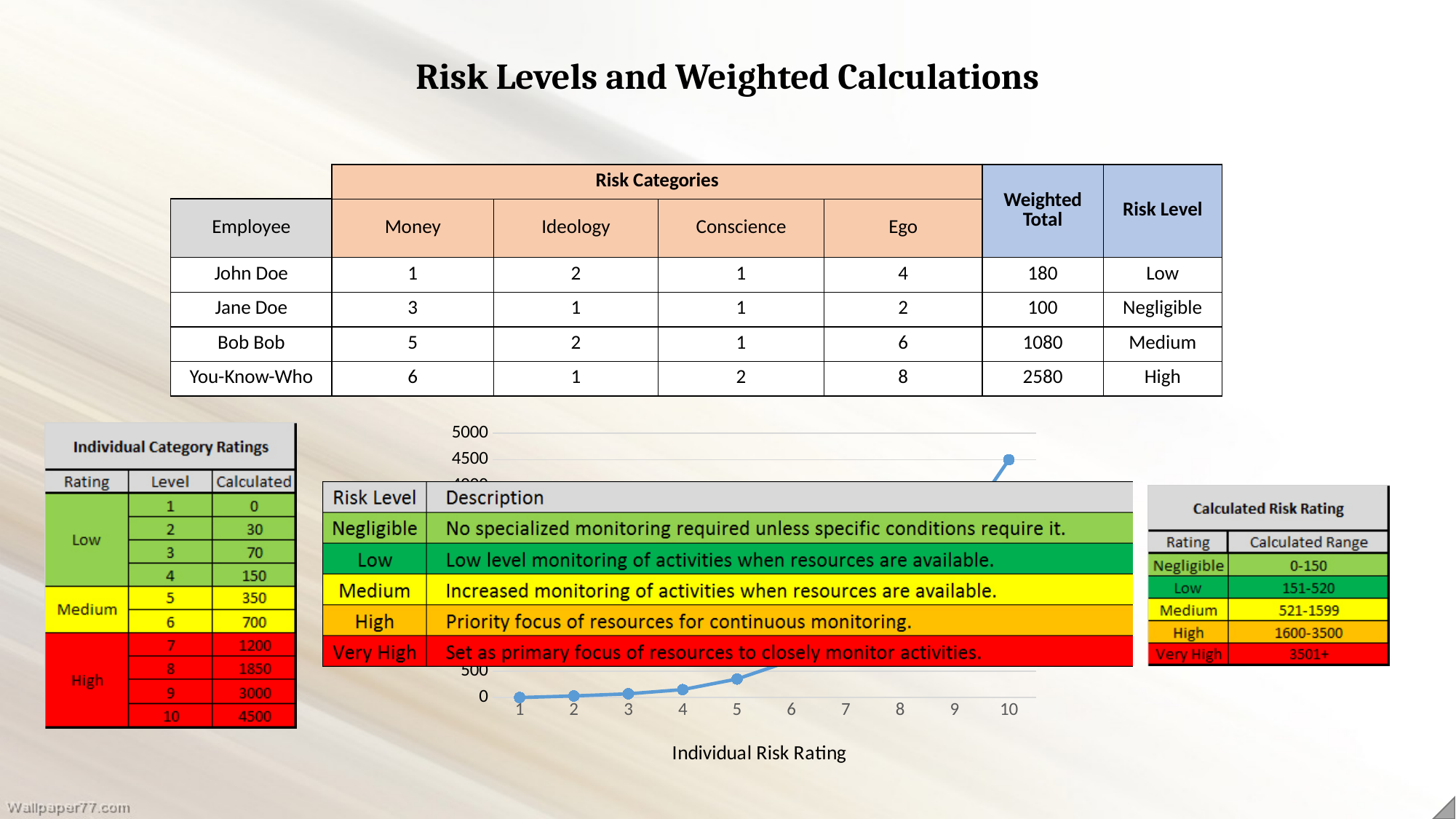
How many individual risk rating values are marked along the x axis of the chart? 10 What is the highest value labelled on the y axis of the chart? 5000 Which has the larger plotted value on the chart, individual risk rating 3 or individual risk rating 10? 10 What value does the chart plot for individual risk rating 1? 0 Which individual risk rating has the lowest plotted value on the chart? 1 Do the plotted values rise or fall as the individual risk rating increases along the x axis? rise Is the plotted value for individual risk rating 5 greater or less than 500? less Is the plotted value for individual risk rating 10 greater or less than 4000? greater What is the x-axis title of the chart? Individual Risk Rating What value does the chart plot for individual risk rating 10? 4500 Which individual risk rating has the highest plotted value on the chart? 10 What kind of chart is shown on the slide? line chart